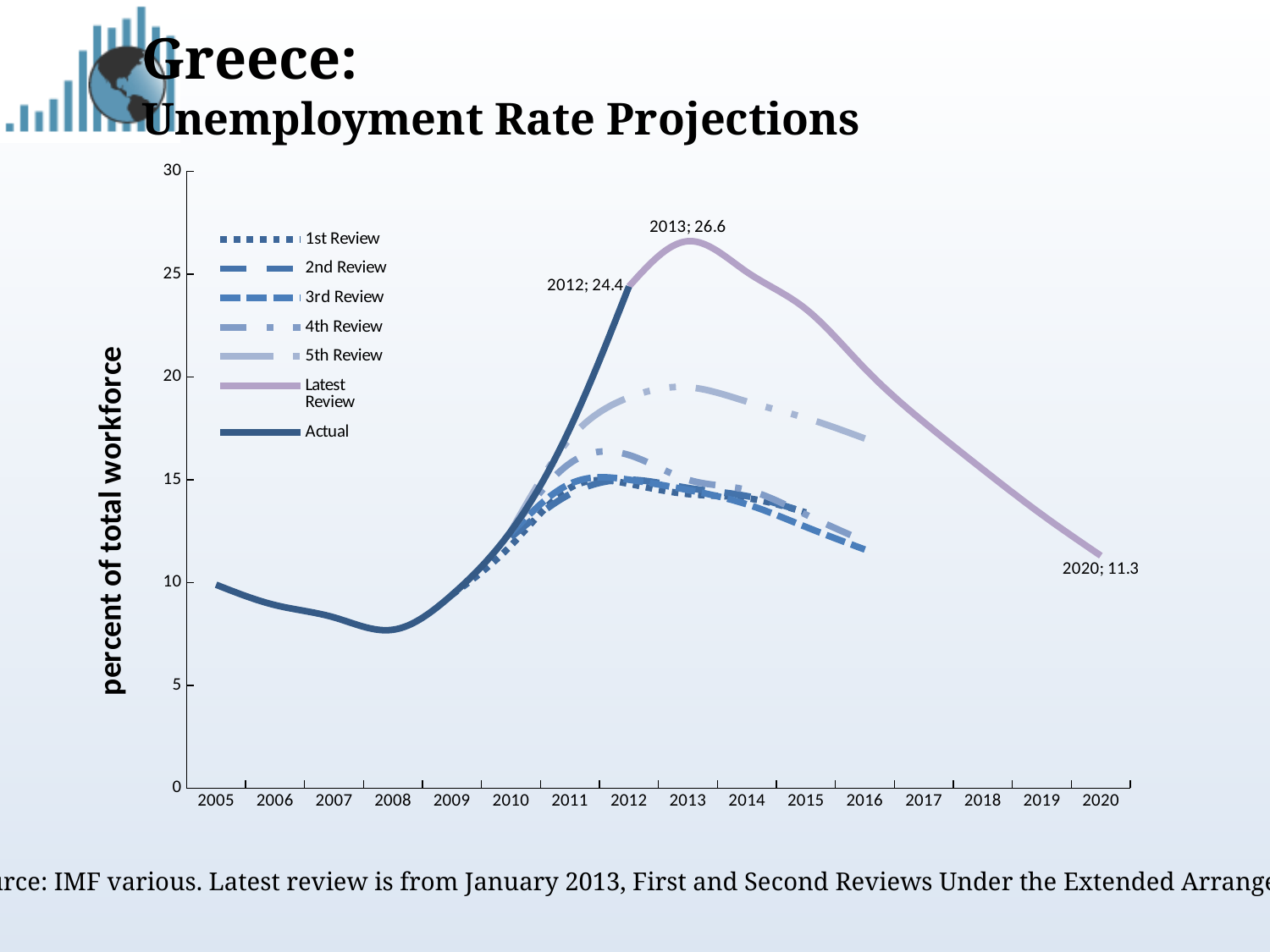
Is the 5th Review value for 2016 greater or less than 15? greater What value is labelled for the Latest Review series in 2020? 11.3 Is the Actual value for 2008 greater or less than 10? less Which is larger: the Latest Review value for 2013 or the Actual value for 2012? Latest Review value for 2013 (26.6) Does the Latest Review series rise or fall from 2013 to 2020? fall What kind of chart is shown on the slide? line chart What is the title of the y axis? percent of total workforce What is the Actual unemployment rate value labelled for 2012? 24.4 What value is labelled for the Latest Review series in 2013? 26.6 How many years are labelled on the x axis? 16 How many series does the legend list? 7 What is the difference between the Latest Review values labelled for 2013 and 2020? 15.3